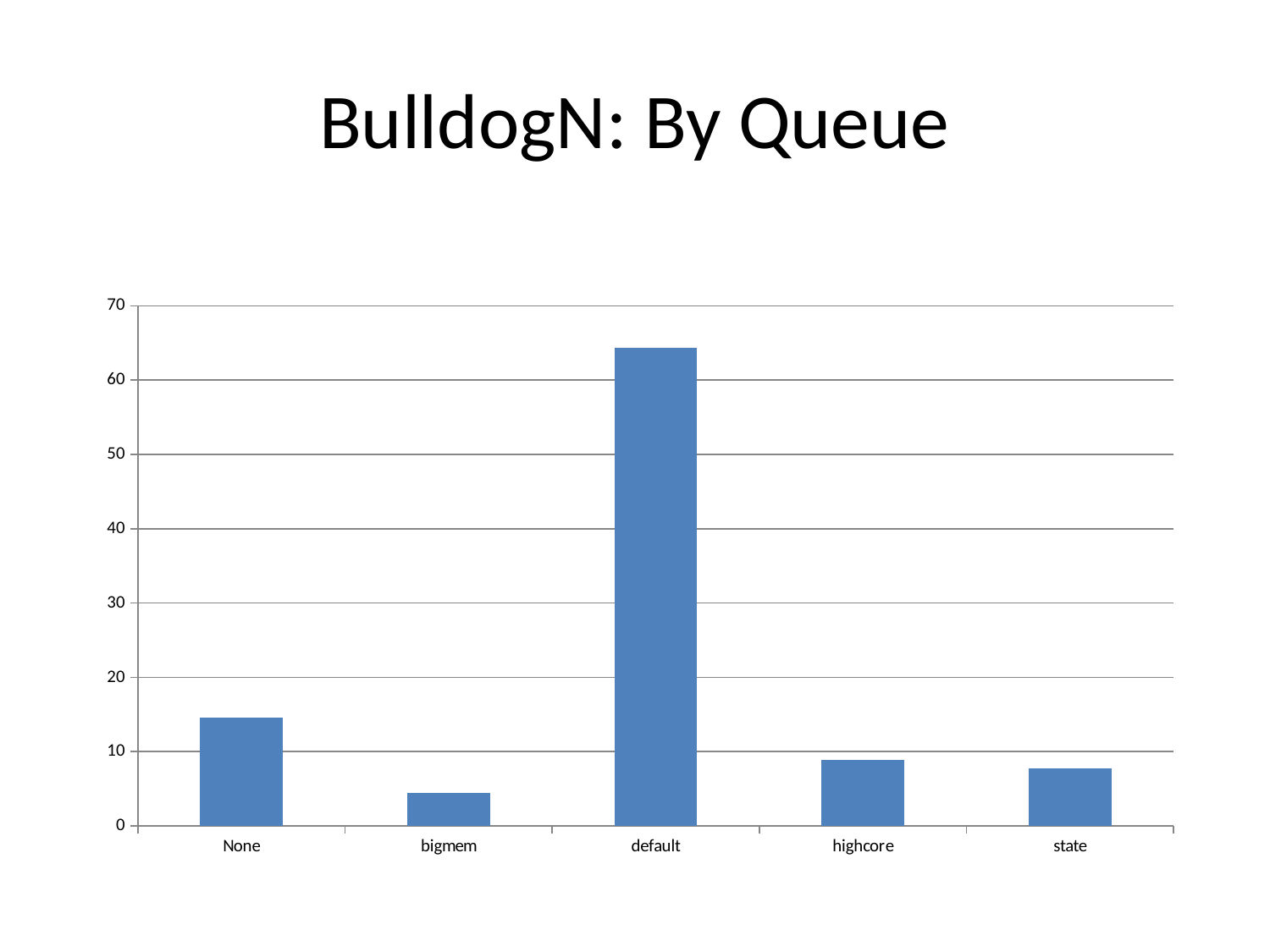
Which queue has the highest value? default Is the value for default greater or less than 70? less Which queue has the lowest value? bigmem Is the value for None greater or less than 10? greater Is the value for state greater or less than 10? less What kind of chart is shown on the slide? bar chart What is the title of the slide? BulldogN: By Queue Which has a larger value, None or bigmem? None How many queue categories are shown on the x axis? 5 Which has a larger value, default or highcore? default